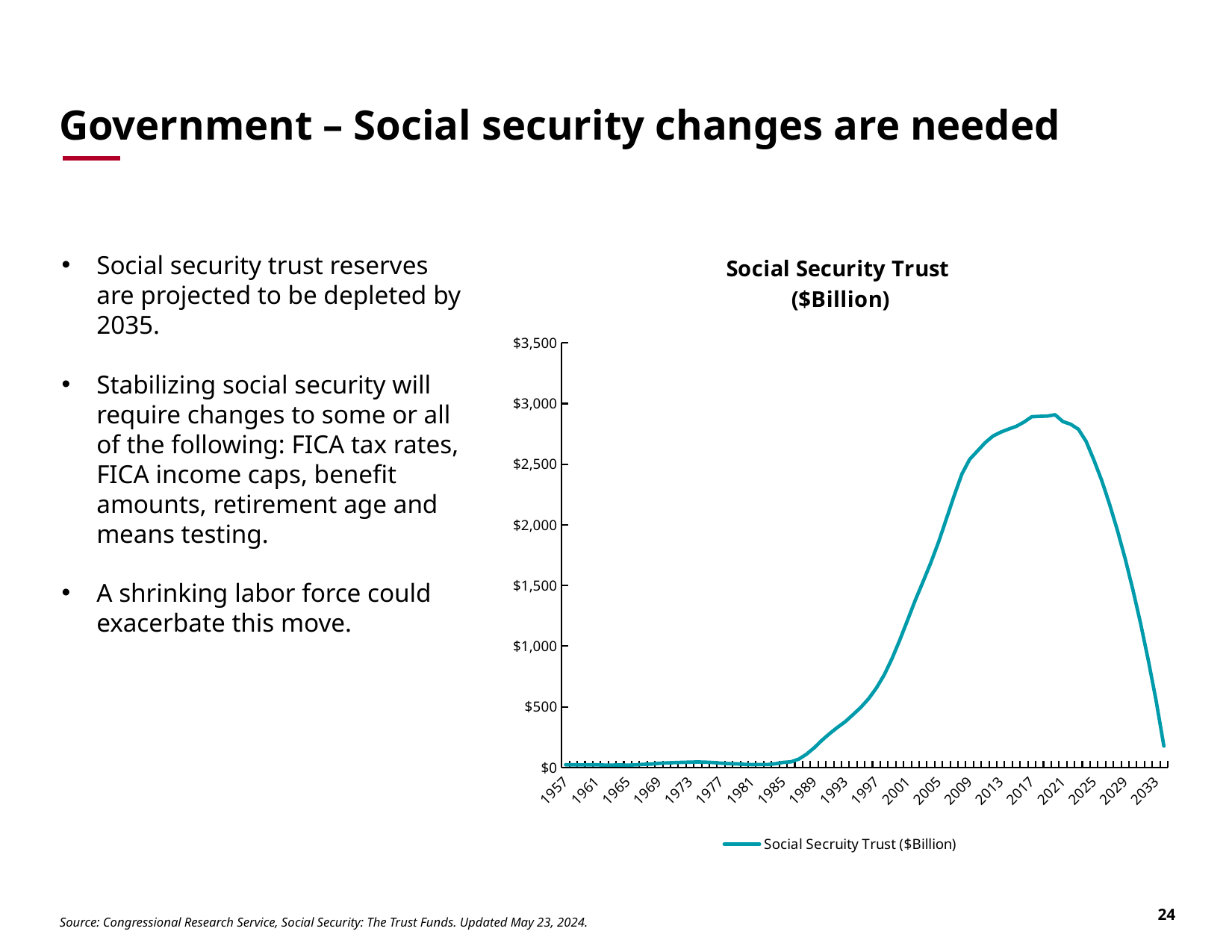
What is the title of the chart? Social Security Trust ($Billion) How many year labels are shown on the x axis of the chart? 20 What kind of chart is shown on the slide? Line chart What colour is the line in the chart? Teal Is the value for 1993 greater or less than $500? less Is the value for 2021 greater or less than $2,500? greater Is the value for 1985 greater or less than $500? less Do the values rise or fall between 2021 and 2033? Fall Do the values rise or fall between 1989 and 2017? Rise How many series does the legend of the chart list? 1